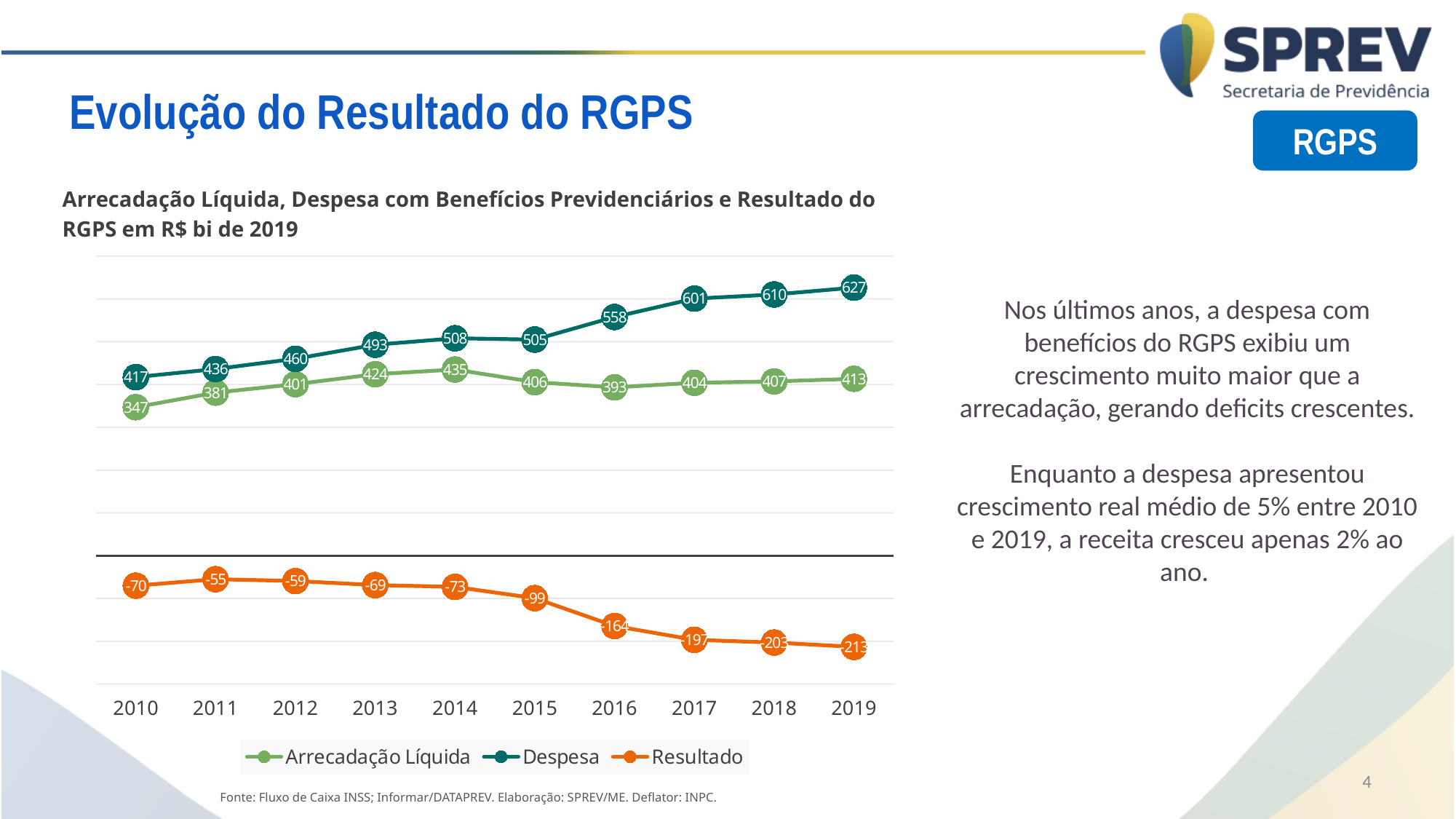
How many years are shown on the x axis? 10 What kind of chart is shown on the slide? Line chart In which year is Despesa lowest? 2010 What is the value of Resultado in 2016? -164 How many series does the legend list? 3 What is the difference between Despesa and Arrecadação Líquida in 2019? 214 Does Despesa rise or fall from 2010 to 2019? Rise Which series is drawn in orange? Resultado What is the value of Despesa in 2019? 627 Which is larger in 2015, Despesa or Arrecadação Líquida? Despesa In which year is Arrecadação Líquida highest? 2014 What is the value of Arrecadação Líquida in 2010? 347